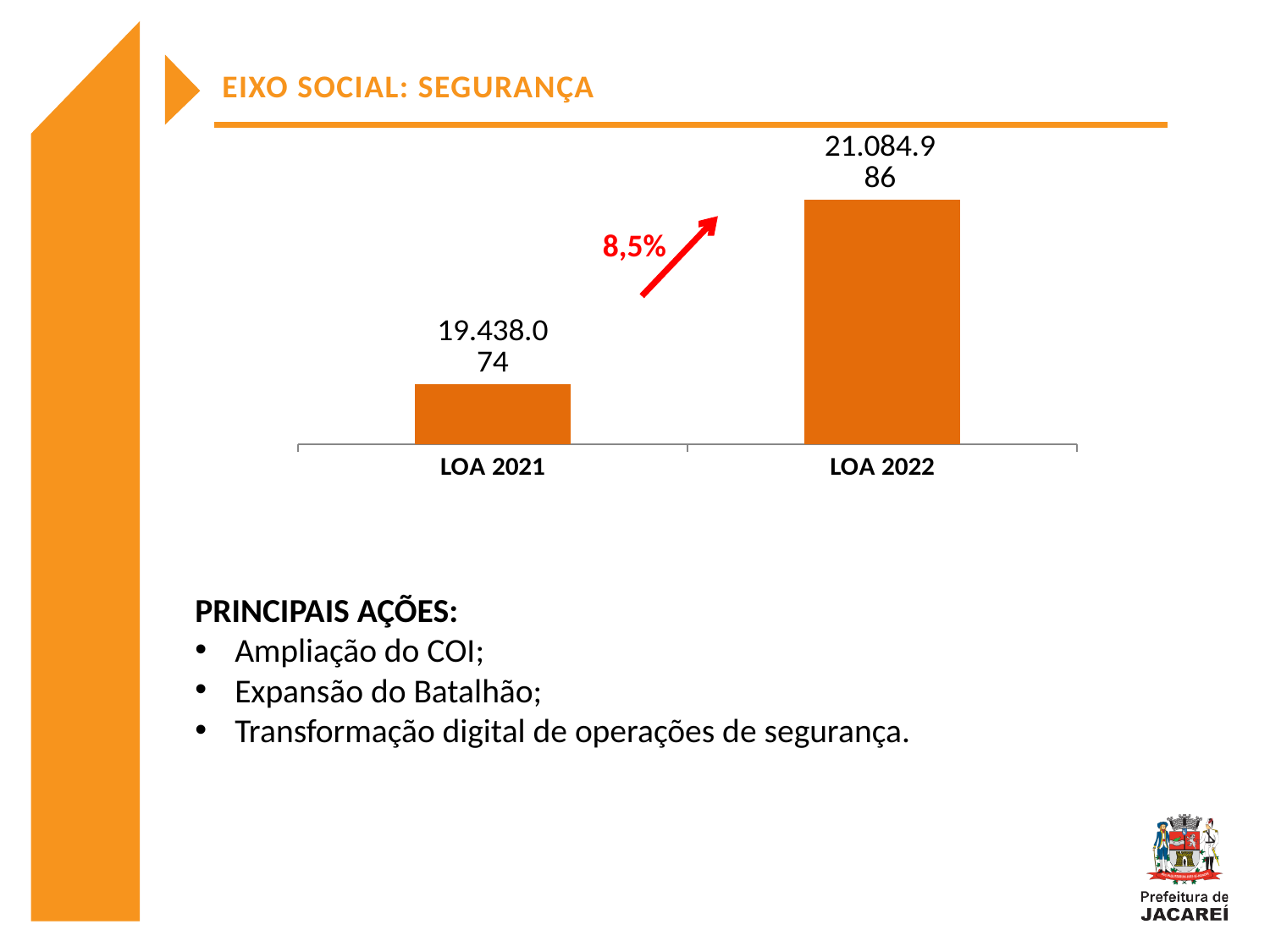
What percentage change is annotated next to the red arrow between the two bars? 8,5% What is the title shown above the chart? EIXO SOCIAL: SEGURANÇA What is the difference between the LOA 2022 and LOA 2021 values? 1.646.912 Which is larger, the value for LOA 2021 or LOA 2022? LOA 2022 Do the values rise or fall from LOA 2021 to LOA 2022? Rise What kind of chart is shown on the slide? Bar chart Which category has the highest value? LOA 2022 How many categories are shown on the x axis? 2 What is the value for LOA 2022? 21.084.986 Which category has the lowest value? LOA 2021 What is the value for LOA 2021? 19.438.074